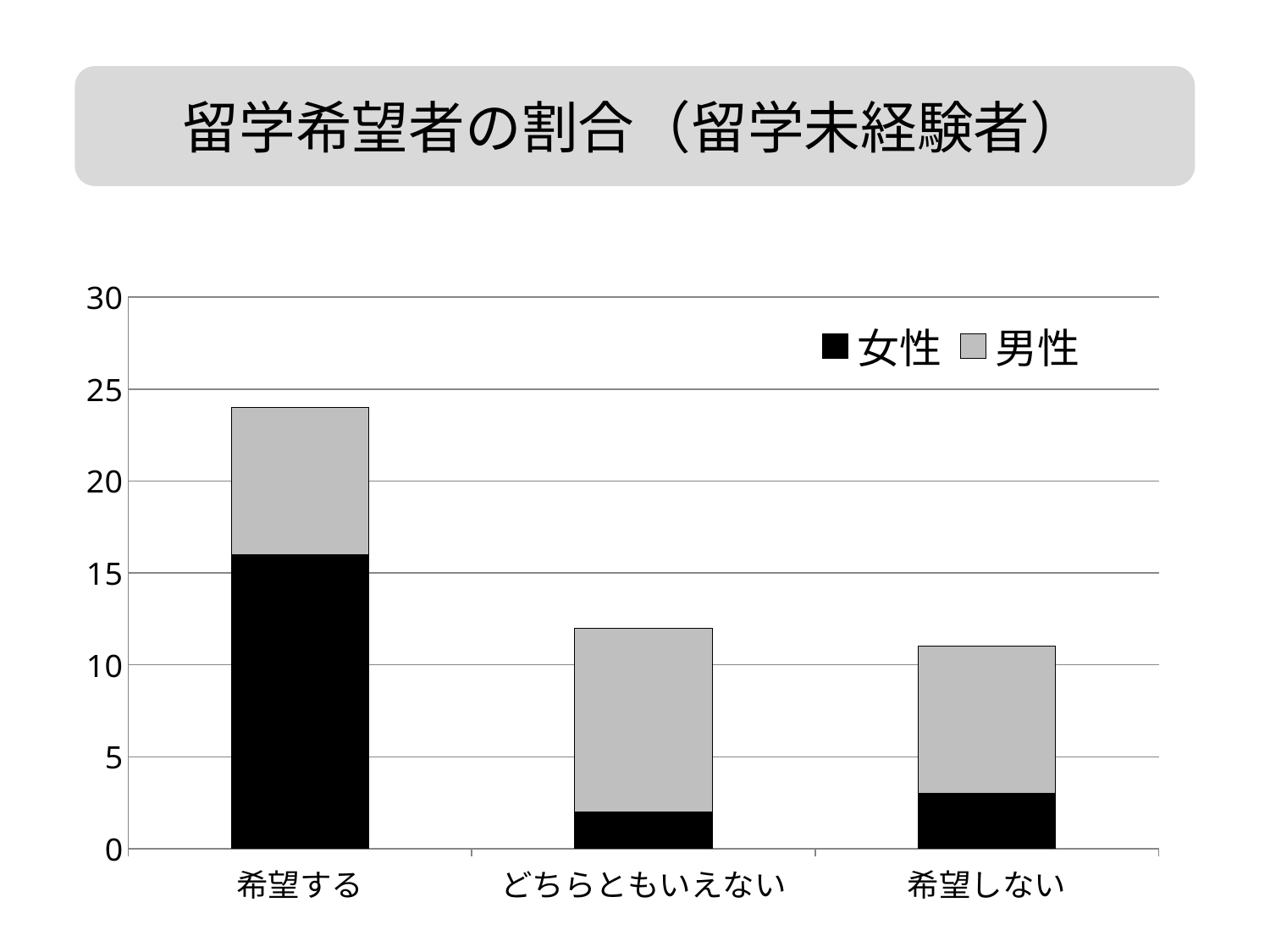
Is the total stacked bar for 希望しない greater or less than 15? less Which category has the larger 女性 segment, 希望する or 希望しない? 希望する Is the total stacked bar for 希望する greater or less than 20? greater How many categories are shown on the x axis of the chart? 3 Which has the larger total stacked bar, 希望する or どちらともいえない? 希望する Is the 女性 value for 希望する greater or less than 10? greater What are the two legend entries of the chart? 女性 and 男性 What kind of chart is shown on the slide? Stacked bar chart Which category has the tallest stacked bar? 希望する How many series does the legend list? 2